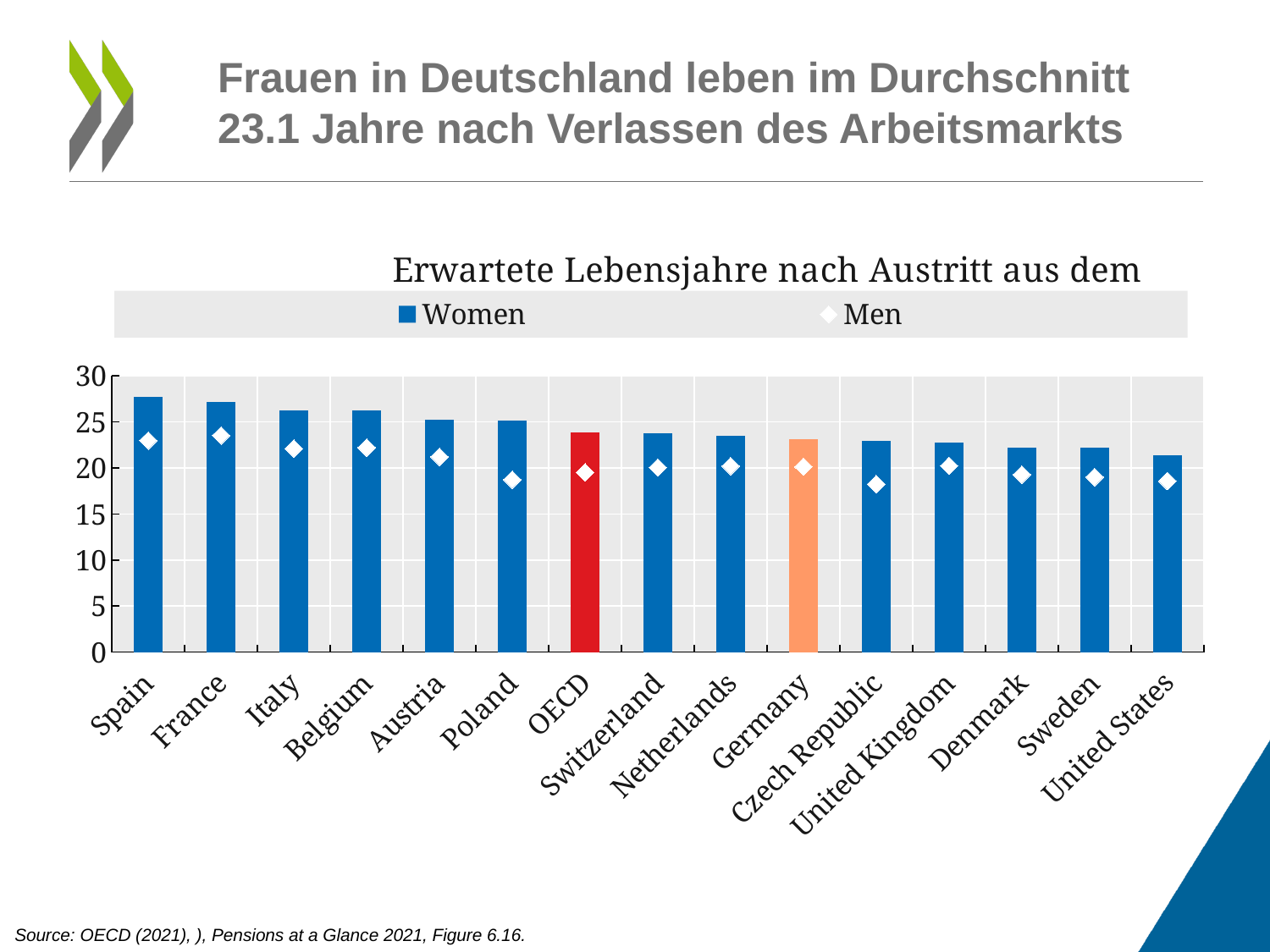
Which category's bar is highlighted in red? OECD Is the Women value for Germany greater or less than 25? less How many countries or groups are shown along the x axis of the chart? 15 Do the Women bars generally rise or fall from left to right along the x axis? fall How many series does the chart legend list? 2 Which category has the lowest Women bar? United States Is the Men value for Spain greater or less than 20? greater Which category has the highest Women bar? Spain Is the Men value for Poland greater or less than 20? less Which is larger, the Women value for Spain or the Women value for United States? Spain What kind of chart is shown on the slide? bar chart